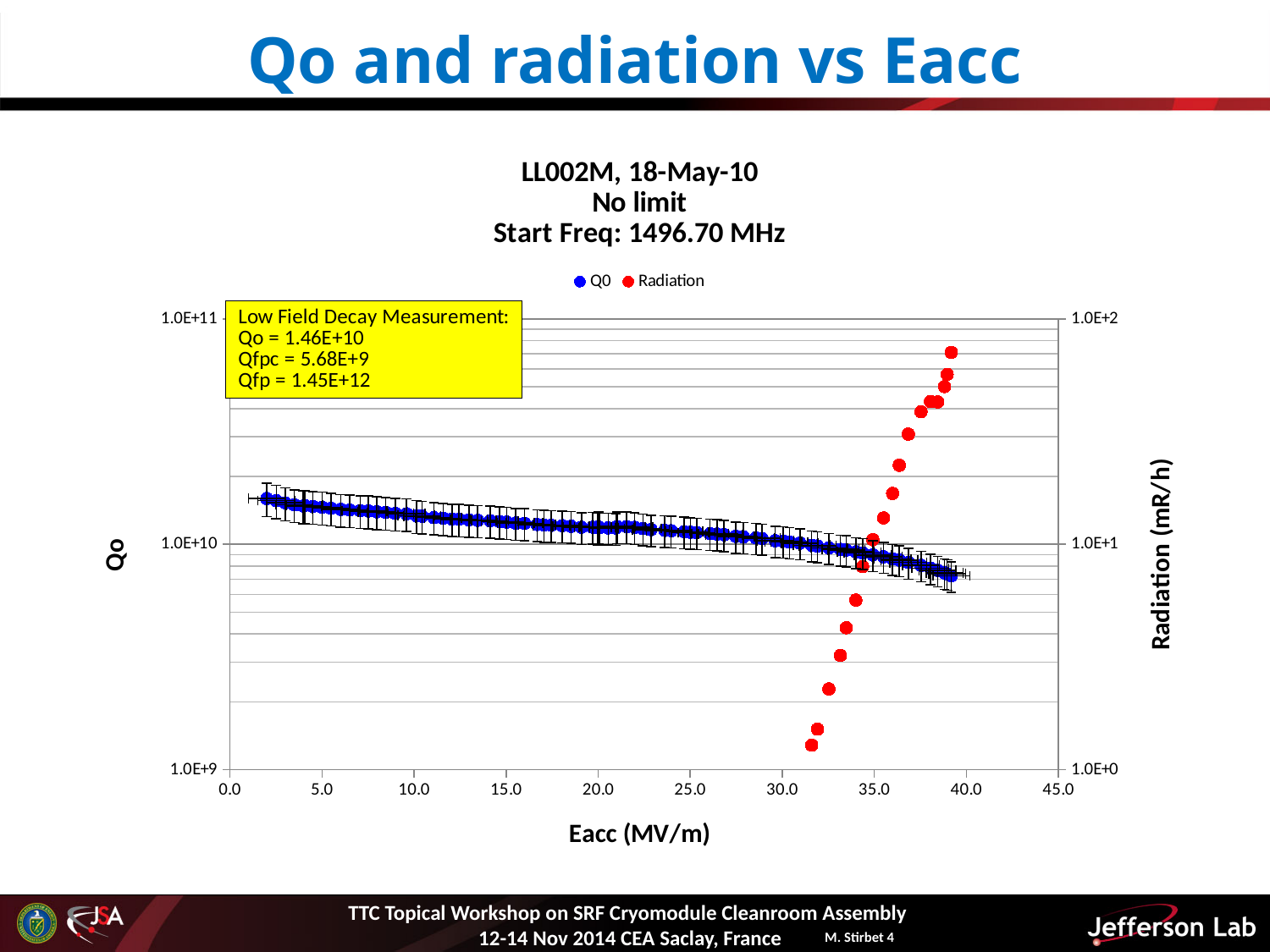
How many series does the legend list? 2 What are the two series named in the legend? Q0 and Radiation What is the Qo value given in the Low Field Decay Measurement box? 1.46E+10 What is the highest tick value shown on the x axis? 45.0 Is the Radiation value at Eacc = 32.0 MV/m greater or less than 1.0E+1? less What is the label of the x axis? Eacc (MV/m) What kind of chart is shown on the slide? Scatter chart Is the Q0 value at Eacc = 5.0 MV/m greater or less than 1.0E+10? greater Is the Q0 value at Eacc = 39.0 MV/m greater or less than 1.0E+10? less Does the Radiation series rise or fall as Eacc increases? Rise Does the Q0 series rise or fall as Eacc increases? Fall